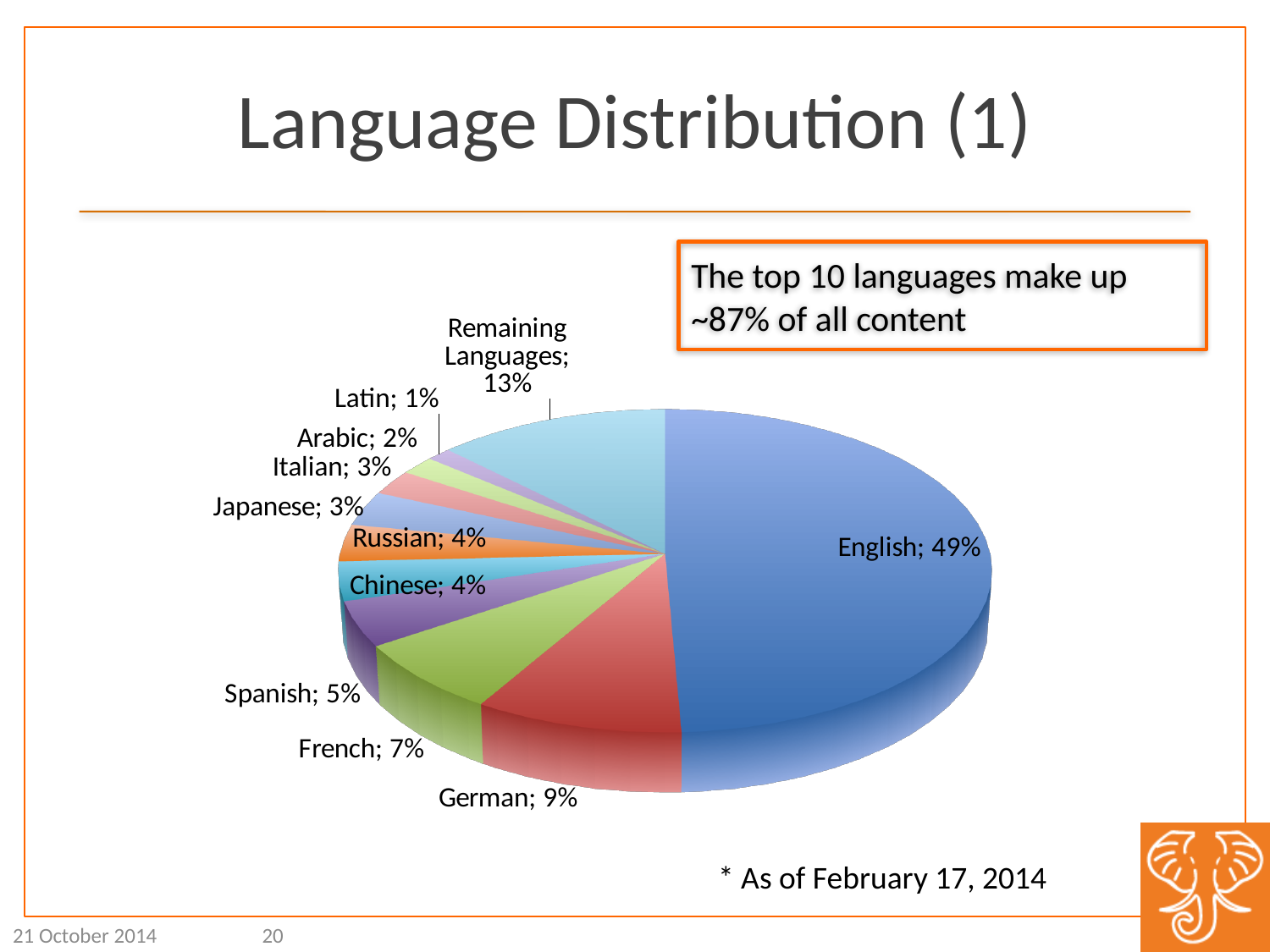
What share of content is English? 49% What is the difference in percentage points between German and French? 2% What share of content is German? 9% How many slices does the pie chart have? 11 What is the difference in percentage points between English and Remaining Languages? 36% What is the title of the slide containing the pie chart? Language Distribution (1) Which is larger, the share for Spanish or the share for Japanese? Spanish What share of content is labelled Remaining Languages? 13% What kind of chart is shown on the slide? Pie chart Which language has the largest slice of the pie? English What share of content is Latin? 1% Which language has the smallest slice of the pie? Latin